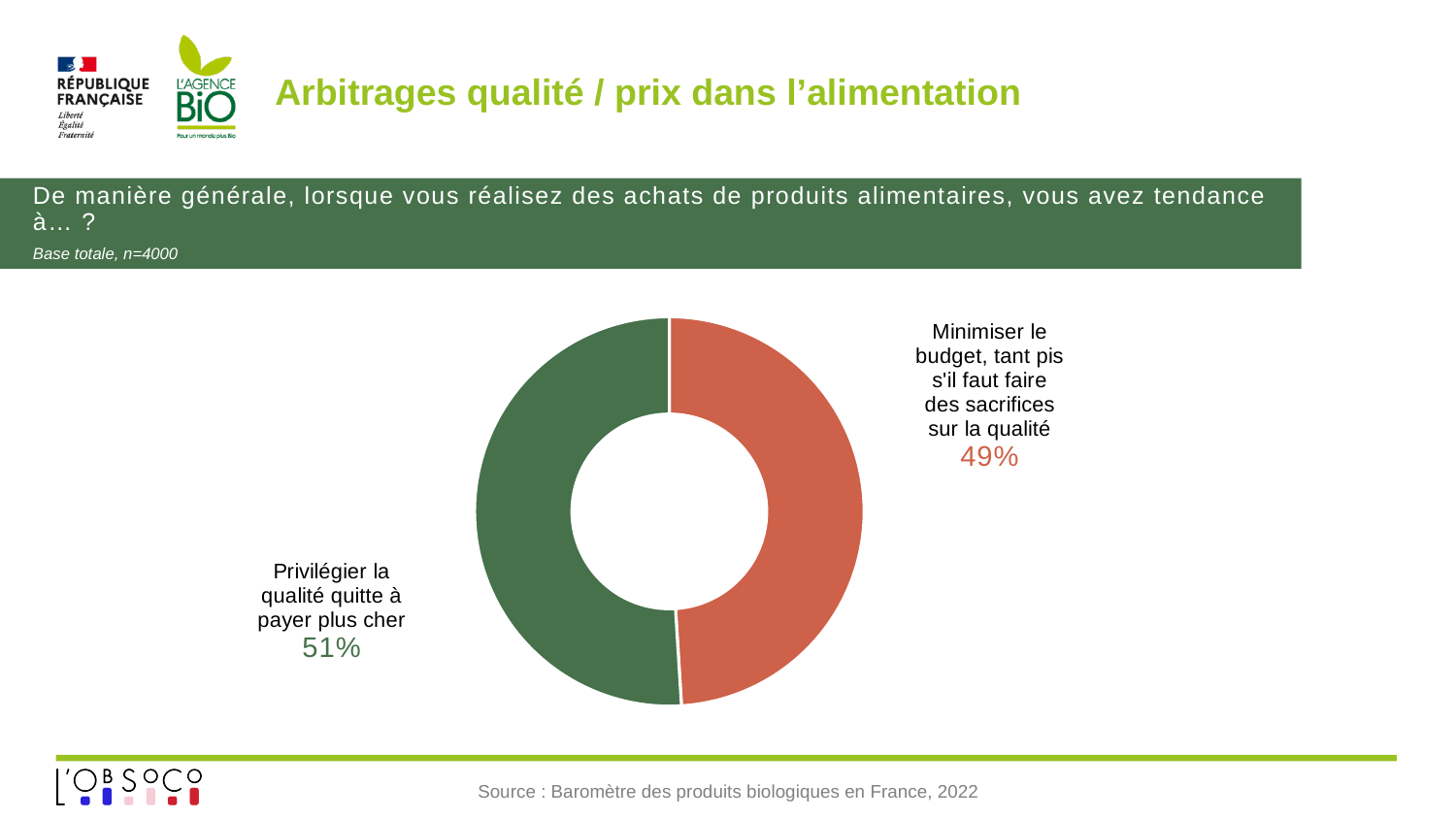
What colour is the slice for "Minimiser le budget, tant pis s'il faut faire des sacrifices sur la qualité"? Red/orange What is the total of the two shares shown in the chart? 100% What percentage of respondents say they prefer quality even if it means paying more ("Privilégier la qualité quitte à payer plus cher")? 51% Which response has the larger share: "Privilégier la qualité quitte à payer plus cher" or "Minimiser le budget"? Privilégier la qualité quitte à payer plus cher What percentage of respondents say they minimise their budget even if it means sacrificing quality ("Minimiser le budget, tant pis s'il faut faire des sacrifices sur la qualité")? 49% Is the share for "Privilégier la qualité quitte à payer plus cher" greater or less than 50%? greater How many categories are shown in the chart? 2 What kind of chart is shown on the slide? Doughnut (pie) chart What is the sample size (base) indicated for the chart? n=4000 What is the difference in percentage points between the two responses shown in the chart? 2 percentage points Which response has the smallest share in the chart? Minimiser le budget, tant pis s'il faut faire des sacrifices sur la qualité